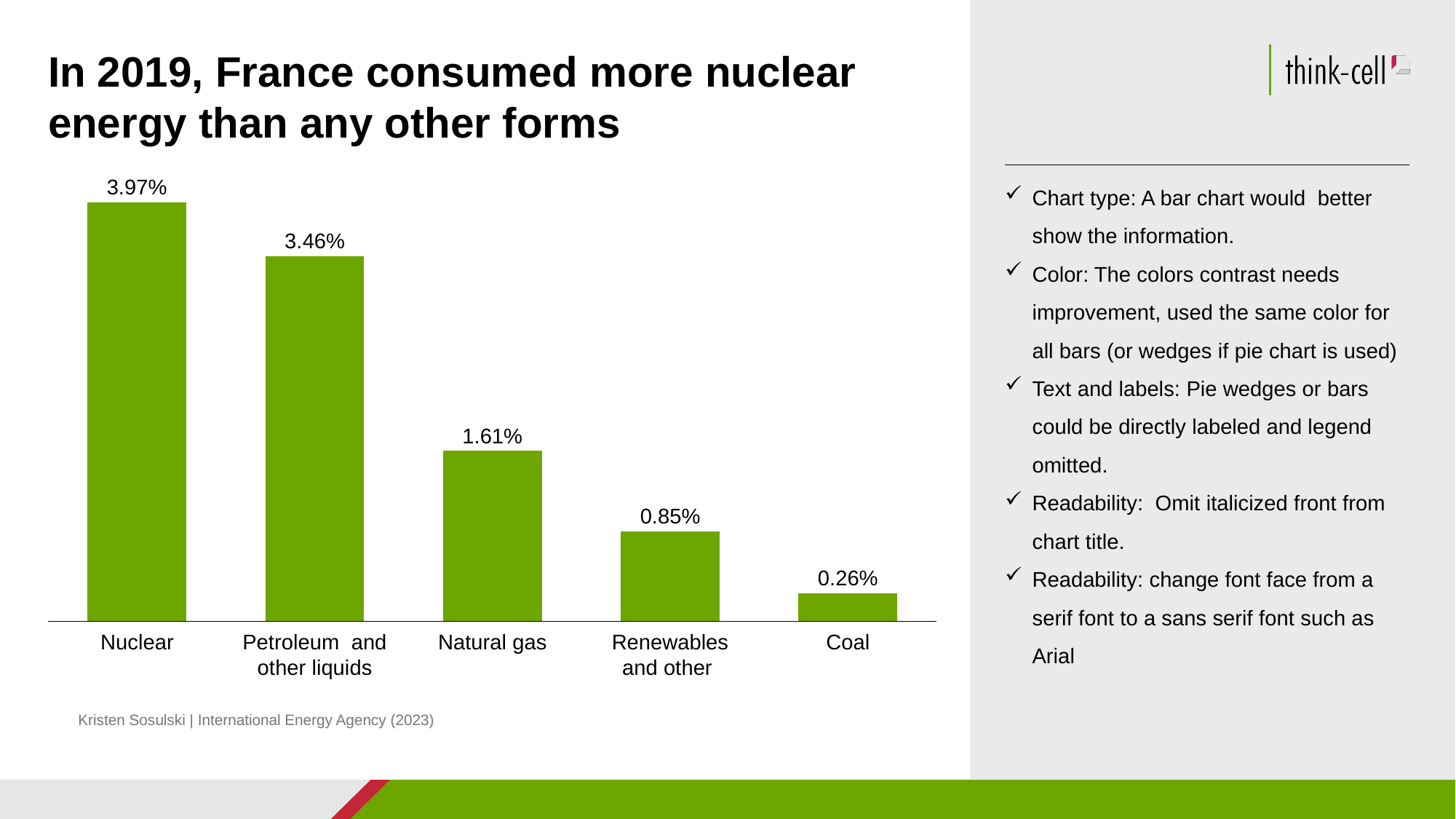
How many categories are shown in the chart? 5 Which is larger, the value for Natural gas or the value for Renewables and other? Natural gas What is the value shown for Petroleum and other liquids? 3.46% Do the values rise or fall from left to right across the categories? Fall Which category has the highest value? Nuclear What is the difference between the values for Nuclear and Petroleum and other liquids? 0.51% What kind of chart is shown on the slide? Bar chart Which category has the lowest value? Coal What is the value shown for Natural gas? 1.61% What is the difference between the values for Natural gas and Renewables and other? 0.76% What is the value shown for Coal? 0.26% What is the value shown for Nuclear? 3.97%